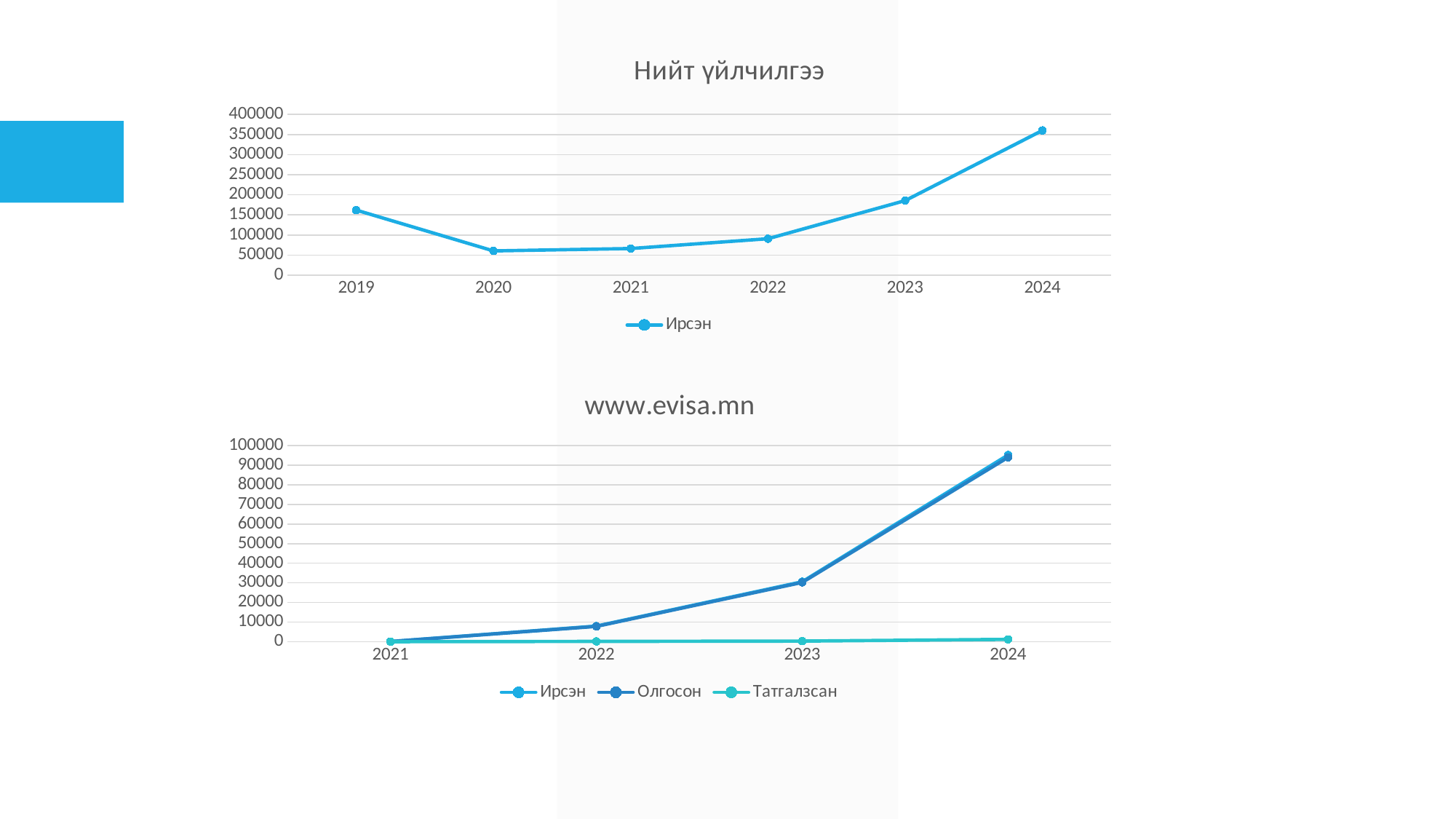
What kind of chart is the top chart titled "Нийт үйлчилгээ"? line chart In the top chart "Нийт үйлчилгээ", is the value for Ирсэн in 2024 greater or less than 300000? greater What is the title of the top chart on the slide? Нийт үйлчилгээ In the bottom chart "www.evisa.mn", is the value for Олгосон in 2024 greater or less than 80000? greater In the top chart "Нийт үйлчилгээ", is the value for Ирсэн in 2020 greater or less than 100000? less In the top chart "Нийт үйлчилгээ", do the values for Ирсэн rise or fall from 2021 to 2024? rise In the top chart "Нийт үйлчилгээ", how many years are shown on the x axis? 6 In the top chart "Нийт үйлчилгээ", which is larger, the value for Ирсэн in 2019 or in 2022? 2019 In the top chart "Нийт үйлчилгээ", which year has the lowest value for Ирсэн? 2020 How many series does the legend of the bottom chart "www.evisa.mn" list? 3 In the bottom chart "www.evisa.mn", which year has the highest value for Олгосон? 2024 In the top chart "Нийт үйлчилгээ", which year has the highest value for Ирсэн? 2024